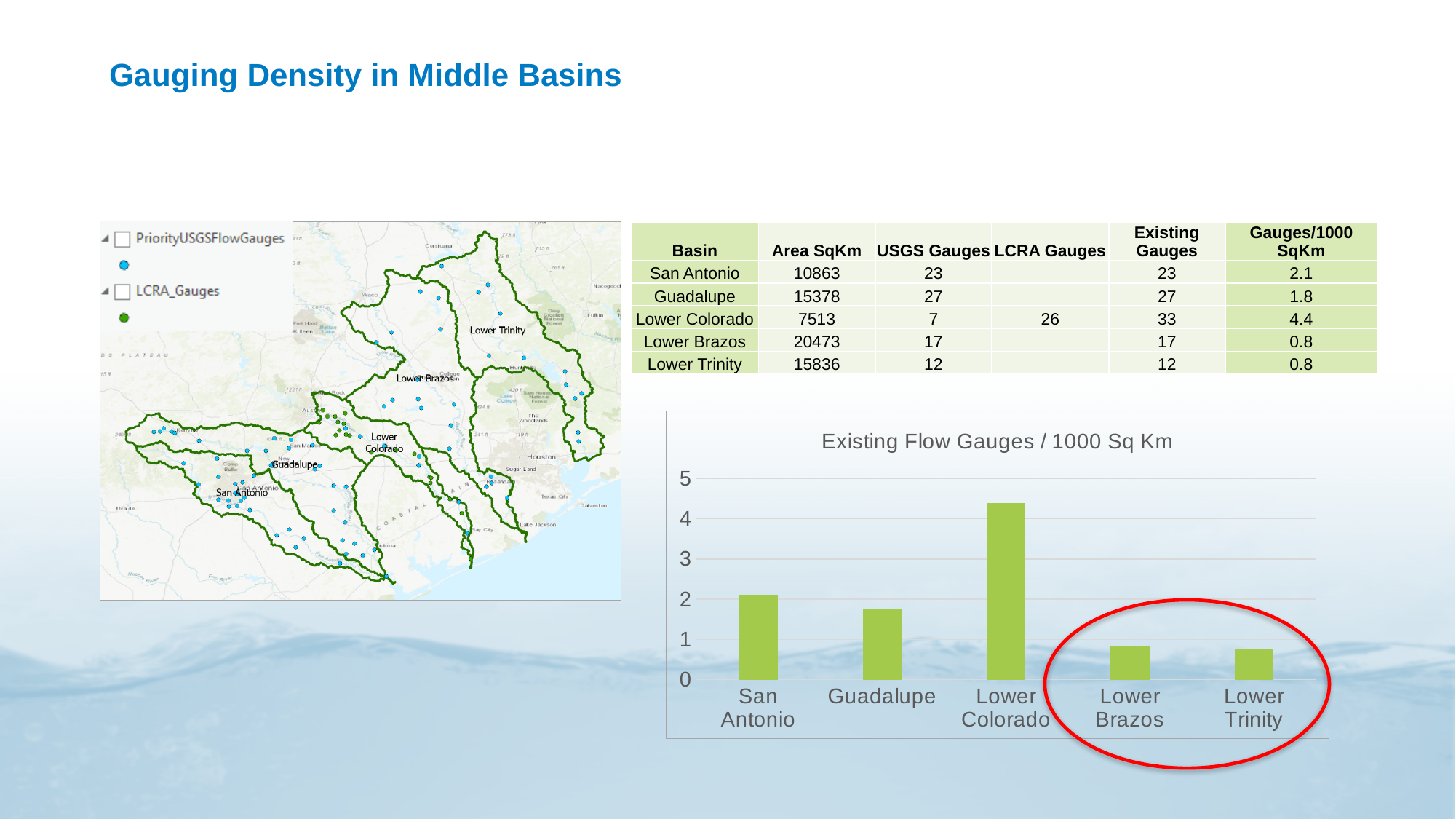
Is the value for Lower Trinity greater or less than 1? less Which is larger in the chart, San Antonio or Guadalupe? San Antonio Is the value for Lower Colorado greater or less than 4? greater What is the value for San Antonio in the chart? 2.1 What type of chart is shown on the slide? bar chart What is the title of the chart? Existing Flow Gauges / 1000 Sq Km What is the value for Lower Brazos in the chart? 0.8 What is the value for Guadalupe in the chart? 1.8 What is the value for Lower Colorado in the chart? 4.4 How many basins are plotted in the chart? 5 What is the difference between the values for Lower Colorado and San Antonio? 2.3 Which basin has the highest value in the chart? Lower Colorado